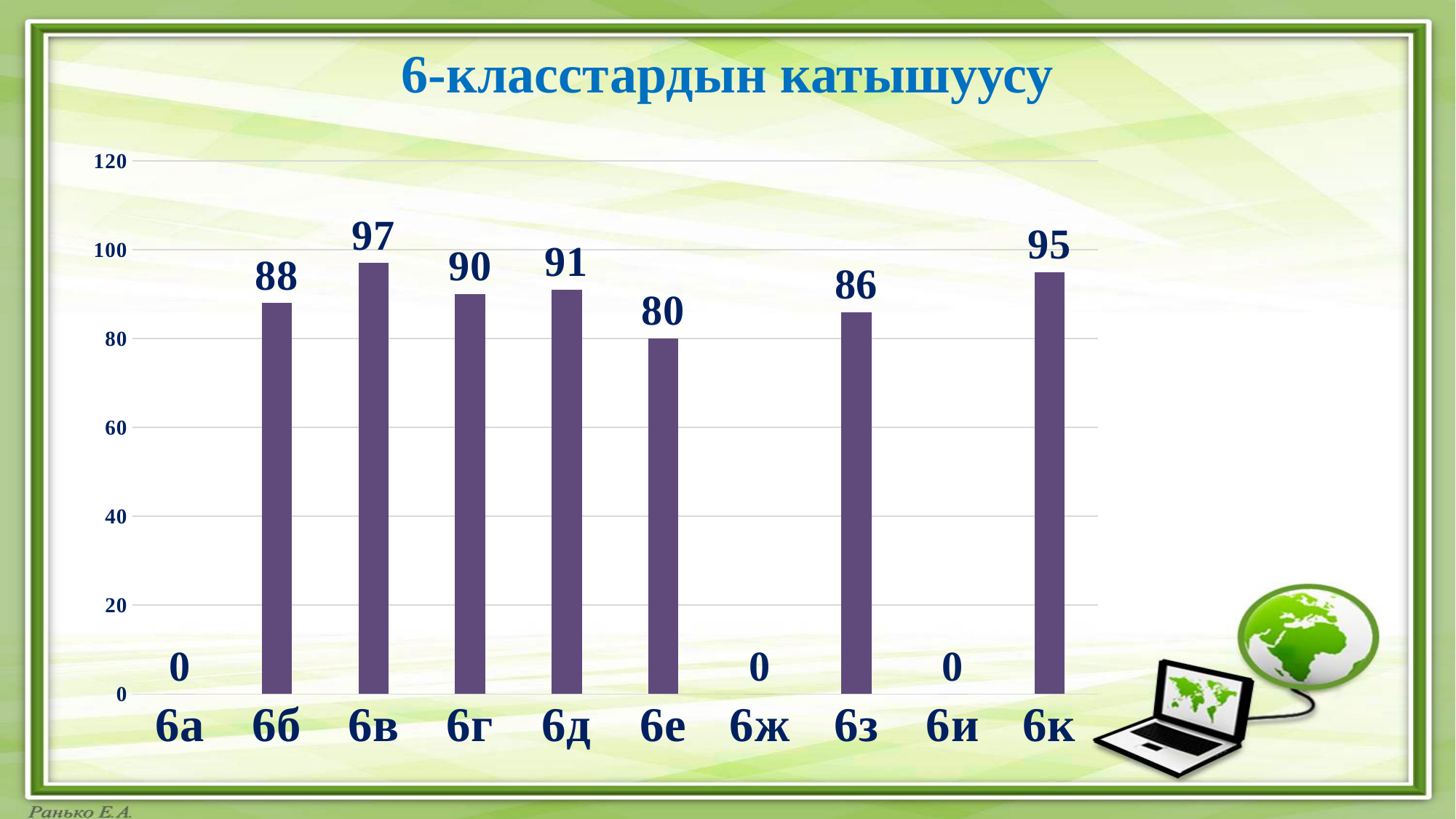
What is the value for 6е? 80 Is the value for 6д greater or less than 100? less How many categories are shown on the x axis? 10 Which is larger, the value for 6б or the value for 6к? 6к Which category has the highest value? 6в What is the value for 6з? 86 Among the categories with non-zero values, which has the lowest value? 6е What is the value for 6в? 97 How many categories have a value of 0? 3 What is the title of the chart? 6-класстардын катышуусу What kind of chart is shown on the slide? bar chart What is the difference between the values for 6в and 6е? 17